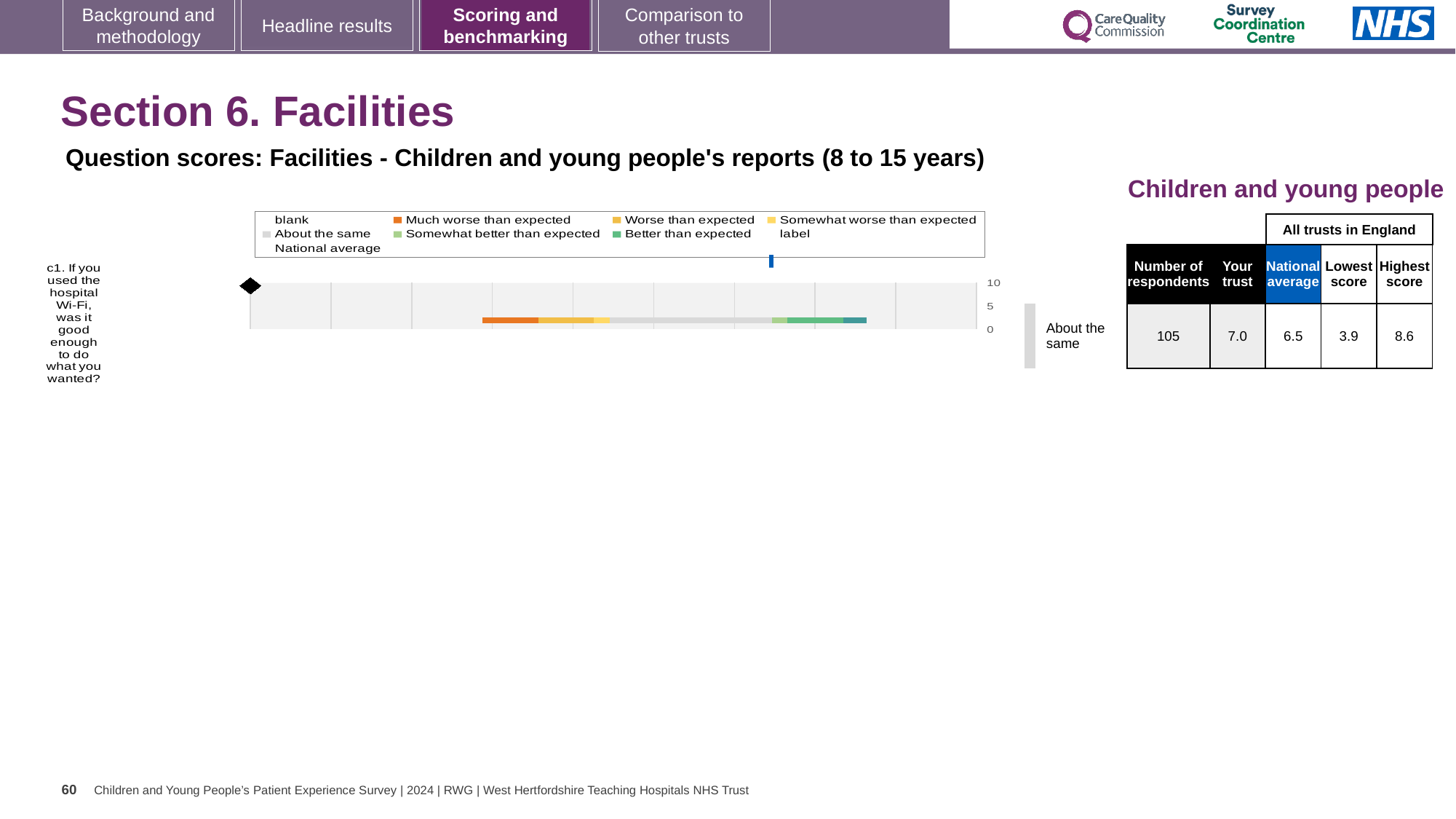
Which colour does the legend use for 'Much worse than expected'? orange What is the 'Your trust' score for question c1 about the hospital Wi-Fi? 7.0 How many respondents answered question c1 about the hospital Wi-Fi? 105 What is the difference between the highest and lowest scores among all trusts in England for question c1? 4.7 What is the highest score among all trusts in England for question c1? 8.6 Which is larger for question c1: the 'Your trust' score or the national average? Your trust What is the lowest score among all trusts in England for question c1? 3.9 What is the maximum value shown on the chart's score axis? 10 What is the national average score for question c1 about the hospital Wi-Fi? 6.5 What kind of chart is used to show the question score for c1 on this slide? bar chart How many survey questions are plotted in the chart on this slide? 1 What is the difference between the 'Your trust' score and the national average for question c1? 0.5